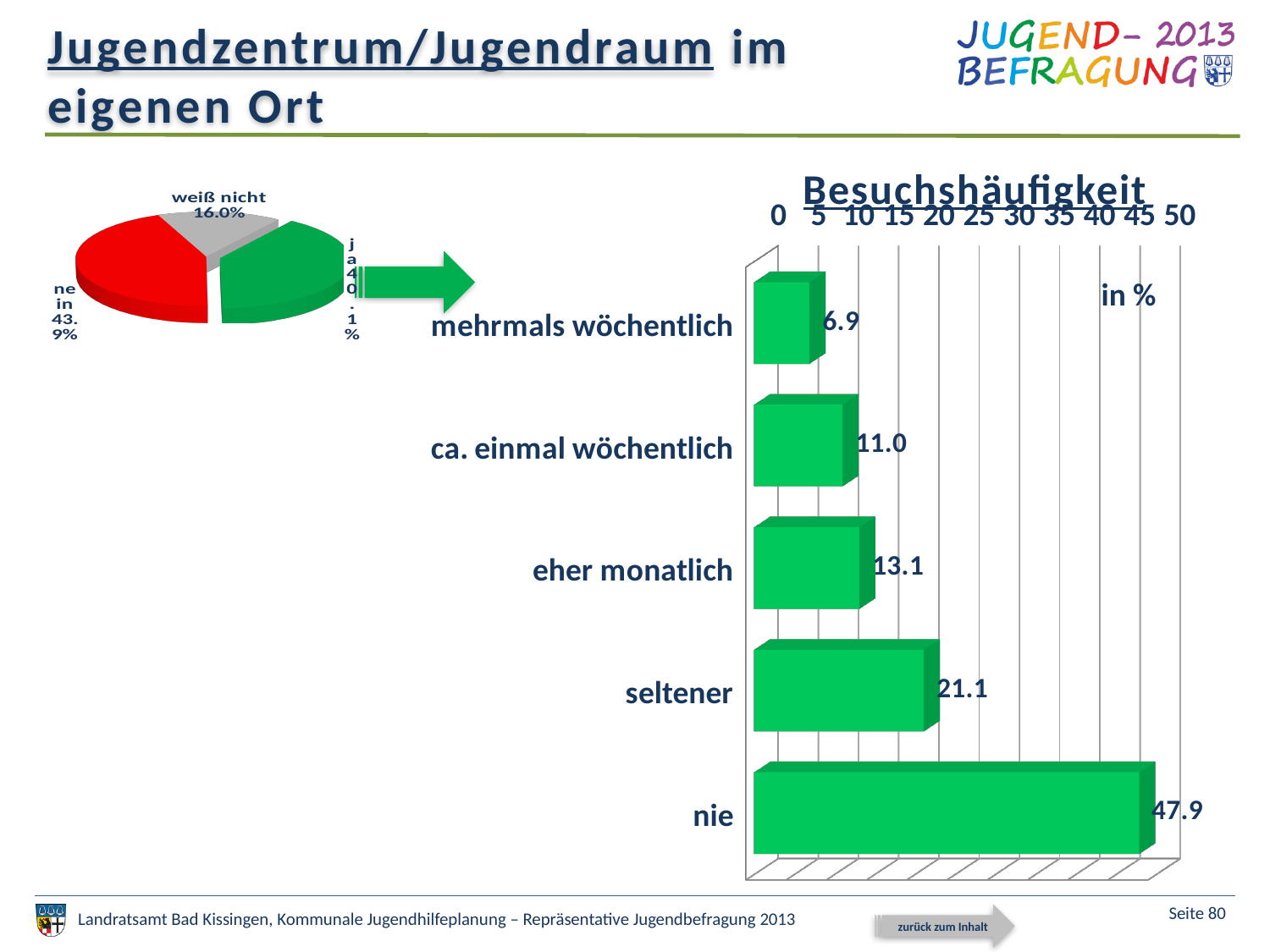
In the Besuchshäufigkeit chart, what is the difference between the values for "nie" and "seltener"? 26.8 In the Besuchshäufigkeit chart, which is larger: "ca. einmal wöchentlich" or "eher monatlich"? eher monatlich In the pie chart on the left, what is the share of the "nein" slice? 43.9% In the Besuchshäufigkeit chart, what is the value for "seltener"? 21.1 What kind of chart is the Besuchshäufigkeit chart? bar chart In the Besuchshäufigkeit chart, what is the value for "mehrmals wöchentlich"? 6.9 What is the title of the bar chart on the right? Besuchshäufigkeit In the Besuchshäufigkeit chart, how many categories are shown? 5 In the Besuchshäufigkeit chart, which category has the highest value? nie In the pie chart on the left, what is the share of the "weiß nicht" slice? 16.0% In the Besuchshäufigkeit chart, which category has the lowest value? mehrmals wöchentlich In the Besuchshäufigkeit chart, what is the value for "nie"? 47.9